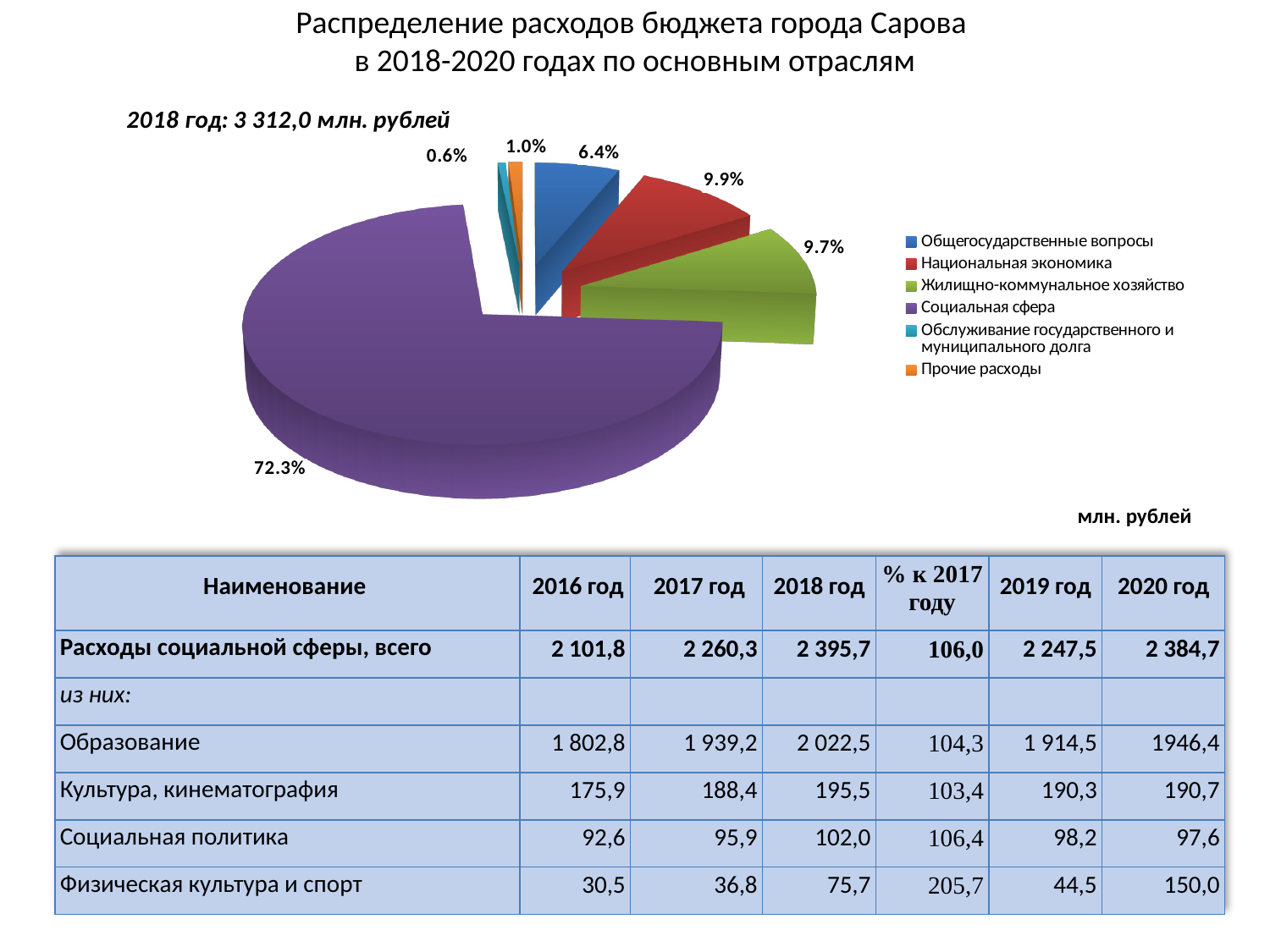
What share of the pie does Жилищно-коммунальное хозяйство have? 9.7% What share of the pie does Национальная экономика have? 9.9% Which has the larger share: Национальная экономика or Жилищно-коммунальное хозяйство? Национальная экономика What share of the pie does Социальная сфера have? 72.3% What kind of chart is shown on the slide? Pie chart How many entries does the legend of the pie chart list? 6 What total amount for 2018 is stated above the pie chart? 3 312,0 млн. рублей Which category has the largest share in the pie chart? Социальная сфера What share of the pie does Общегосударственные вопросы have? 6.4% What colour is the Социальная сфера slice in the pie chart? Purple By how many percentage points does the share of Социальная сфера exceed that of Национальная экономика? 62.4 percentage points How many slices does the pie chart have? 6